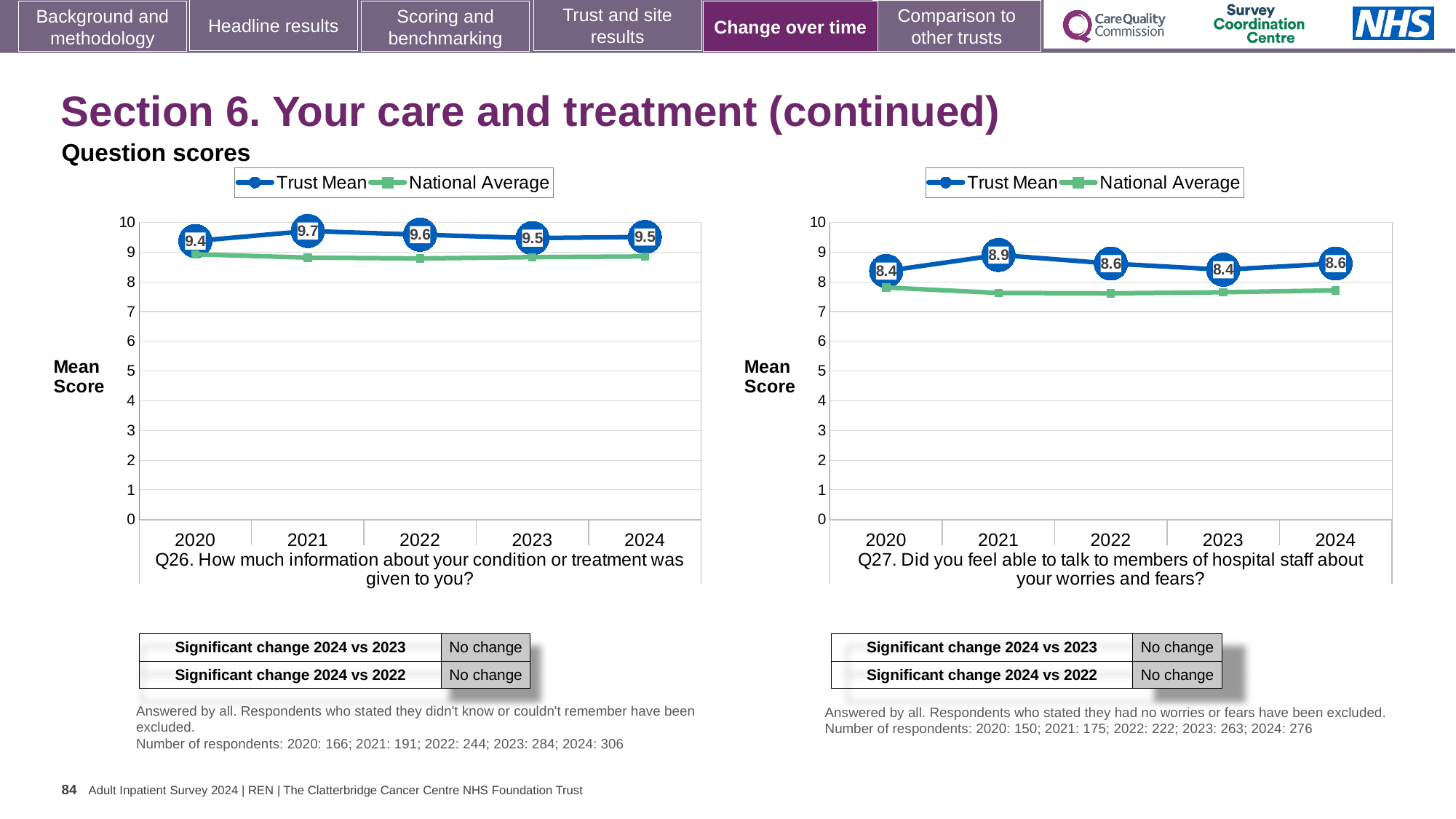
In the Q27 chart on the right, which year has the highest Trust Mean score? 2021 How many series does the legend of the Q27 chart on the right list? 2 In the Q26 chart on the left, which year has the lowest Trust Mean score? 2020 What kind of chart is the Q26 chart on the left? Line chart In the Q26 chart on the left, does the Trust Mean rise or fall from 2021 to 2023? Fall In the Q27 chart on the right, what is the Trust Mean score for 2024? 8.6 In the Q26 chart on the left, what is the Trust Mean score for 2021? 9.7 In the Q27 chart on the right, is the National Average value for 2022 greater or less than 8? less In the Q26 chart on the left, which is larger, the Trust Mean for 2021 or the Trust Mean for 2023? 2021 In the Q26 chart on the left, what is the Trust Mean score for 2020? 9.4 In the Q27 chart on the right, what is the difference between the Trust Mean scores for 2021 and 2020? 0.5 How many years are plotted on the x axis of the Q26 chart on the left? 5